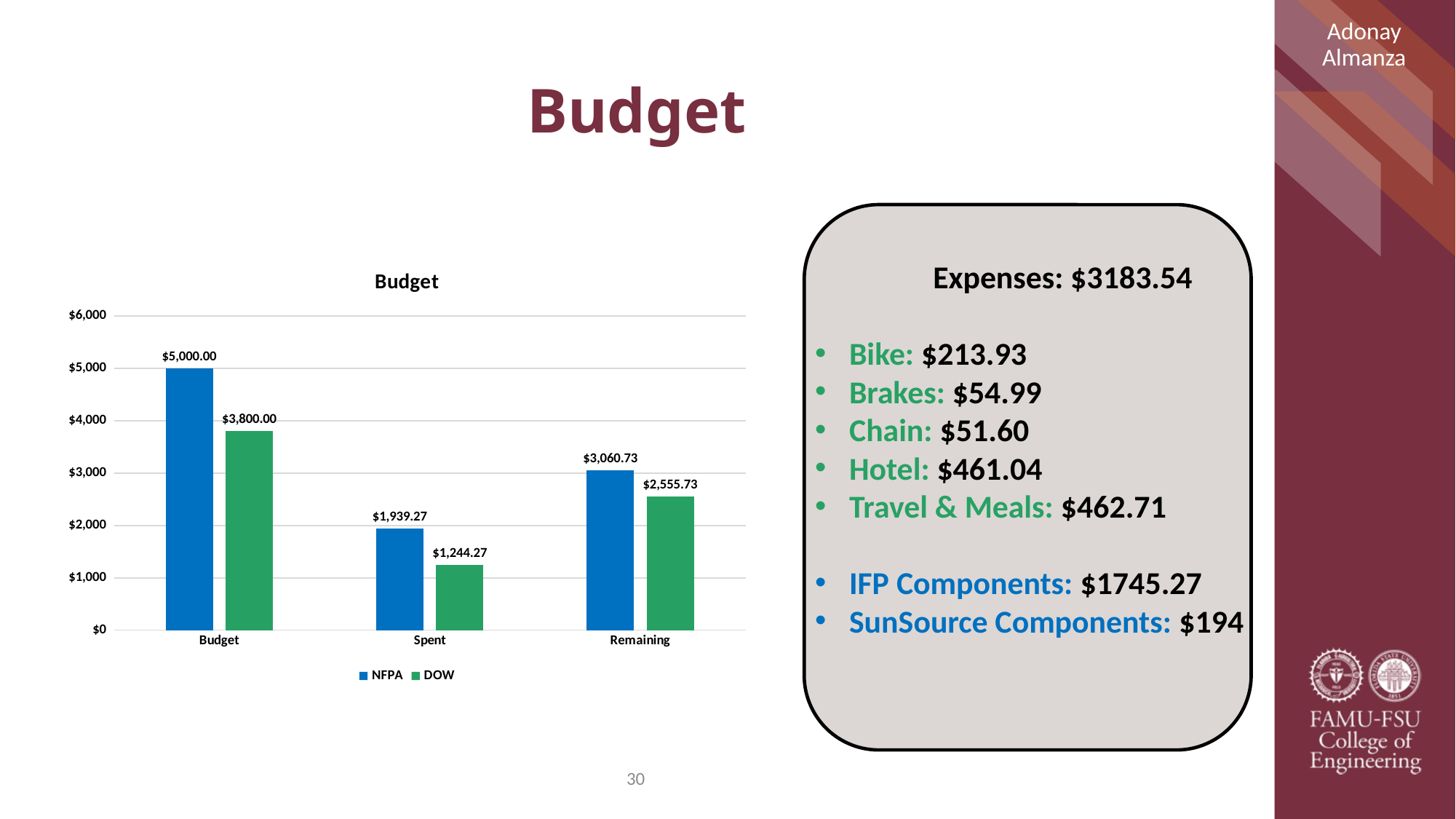
What is the NFPA value for the Budget category? $5,000.00 Which category has the lowest DOW value? Spent Which category has the highest NFPA value? Budget How many series does the legend list? 2 What is the NFPA value for the Remaining category? $3,060.73 What is the DOW value for the Spent category? $1,244.27 Which is larger for the Remaining category, NFPA or DOW? NFPA How many categories are shown on the x axis? 3 What is the DOW value for the Budget category? $3,800.00 What is the difference between the NFPA and DOW values for the Spent category? $695.00 What kind of chart is shown? bar chart Is the DOW value for Remaining greater or less than $2,000? greater